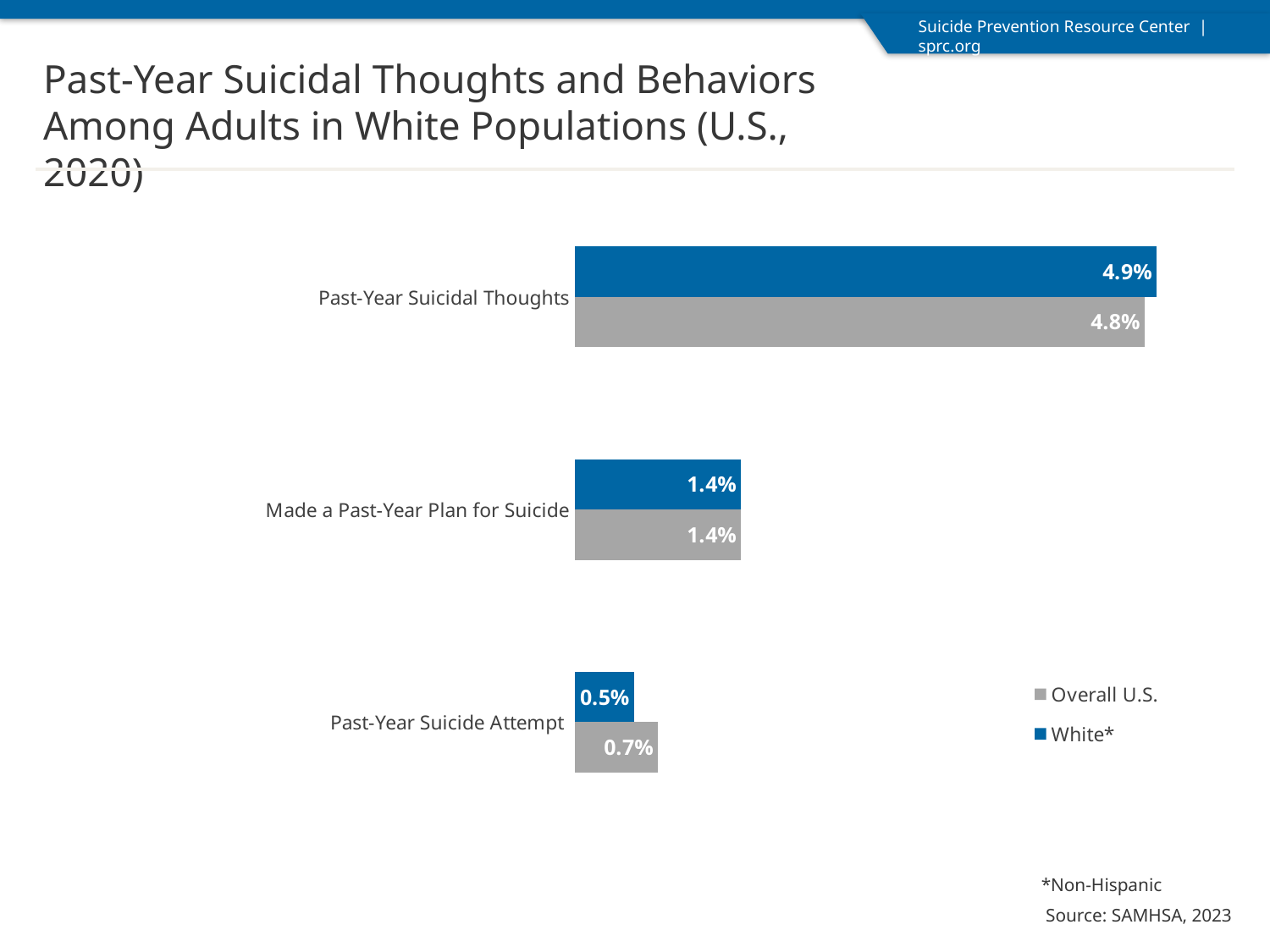
What is the value for White* for Past-Year Suicidal Thoughts? 4.9% Which category has the lowest value for the Overall U.S. series? Past-Year Suicide Attempt What is the value for White* for Made a Past-Year Plan for Suicide? 1.4% What kind of chart is shown on the slide? Bar chart For Past-Year Suicide Attempt, which is larger: the Overall U.S. value or the White* value? Overall U.S. Which category has the highest value for the White* series? Past-Year Suicidal Thoughts What is the difference between the Overall U.S. and White* values for Past-Year Suicide Attempt? 0.2% What is the value for Overall U.S. for Past-Year Suicidal Thoughts? 4.8% How many series does the legend list? 2 What is the value for White* for Past-Year Suicide Attempt? 0.5% What is the value for Overall U.S. for Past-Year Suicide Attempt? 0.7% How many categories are shown on the chart? 3